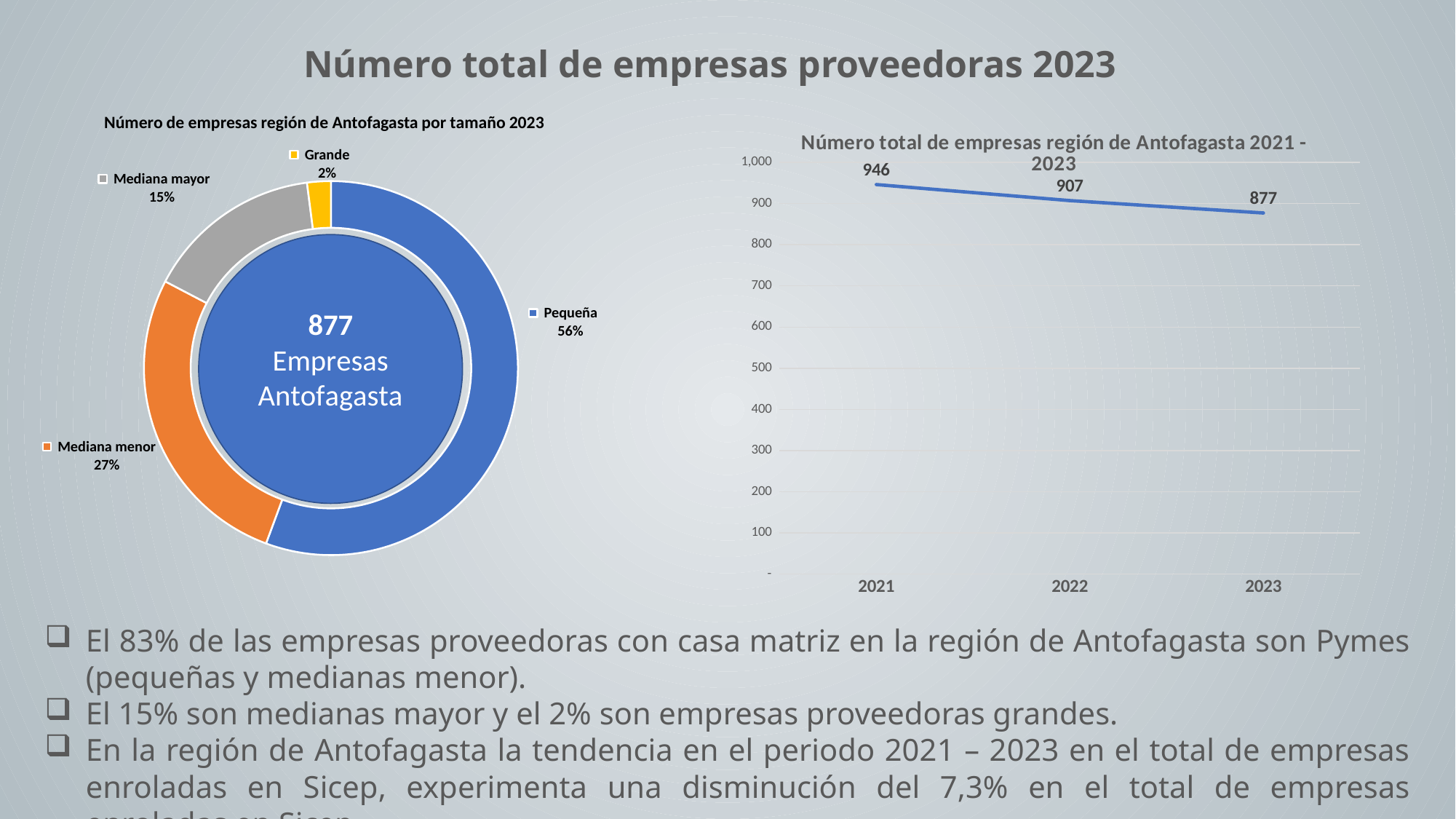
In the chart 'Número de empresas región de Antofagasta por tamaño 2023', which category has the largest share? Pequeña In the chart 'Número de empresas región de Antofagasta por tamaño 2023', what share do Pequeña companies represent? 56% In the chart 'Número total de empresas región de Antofagasta 2021 - 2023', do the values rise or fall from 2021 to 2023? fall In the chart 'Número de empresas región de Antofagasta por tamaño 2023', what share do Mediana menor companies represent? 27% In the chart 'Número de empresas región de Antofagasta por tamaño 2023', how many categories are shown? 4 In the chart 'Número total de empresas región de Antofagasta 2021 - 2023', what is the value for 2022? 907 In the chart 'Número total de empresas región de Antofagasta 2021 - 2023', what is the difference between the 2021 and 2023 values? 69 What kind of chart is 'Número total de empresas región de Antofagasta 2021 - 2023'? line chart What total number of companies is shown in the centre of the doughnut chart on the left? 877 In the chart 'Número de empresas región de Antofagasta por tamaño 2023', which category has the smallest share? Grande In the chart 'Número de empresas región de Antofagasta por tamaño 2023', what is the difference in percentage points between Mediana mayor and Grande? 13 percentage points In the chart 'Número total de empresas región de Antofagasta 2021 - 2023', what is the value for 2021? 946